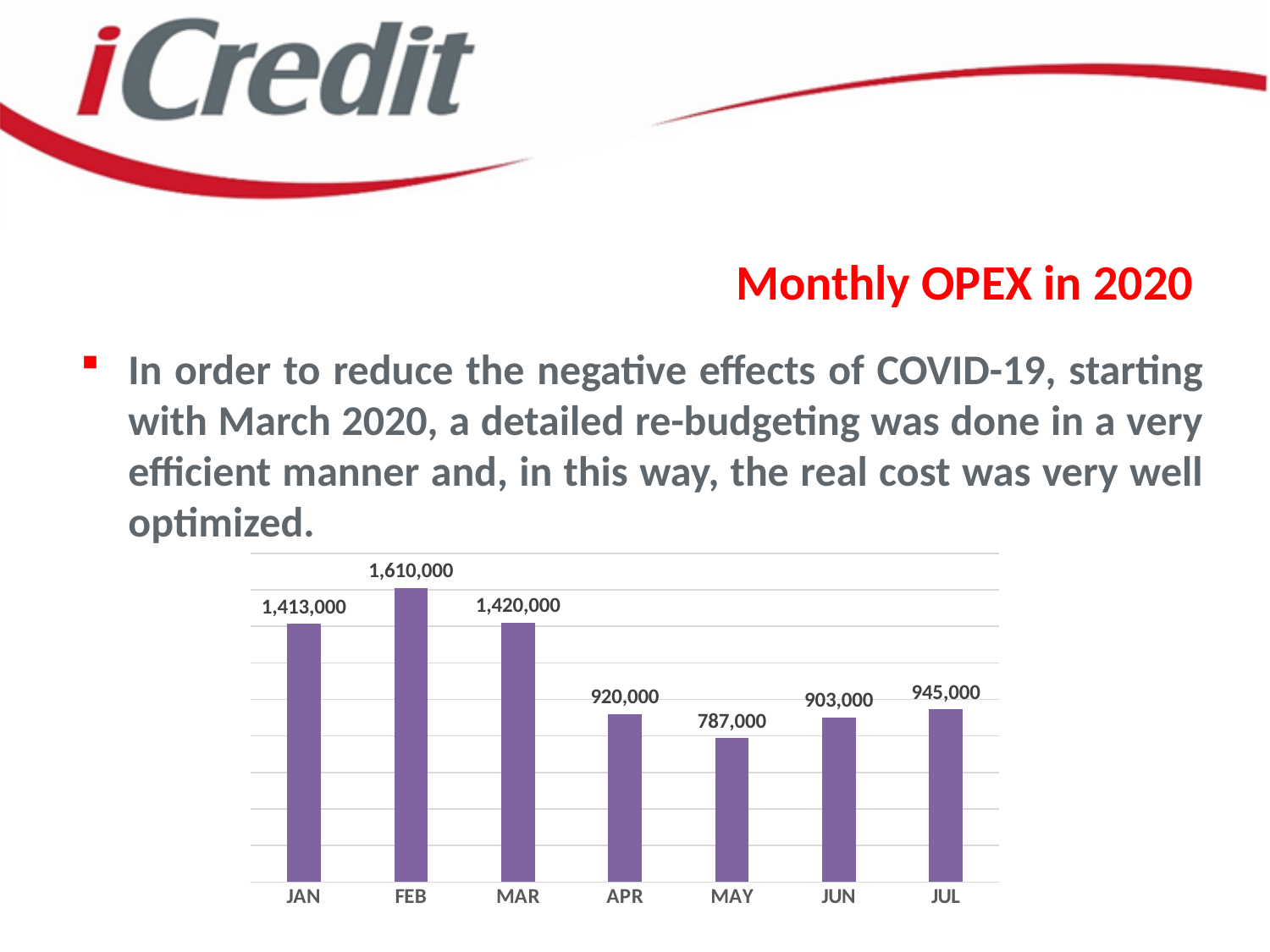
What kind of chart is shown on the slide? bar chart Which month has the lowest value? MAY What is the value for FEB? 1,610,000 What is the value for JUL? 945,000 How many months are shown on the x axis? 7 What is the difference between the values for APR and MAY? 133,000 Which month has the highest value? FEB Which is larger, the value for JAN or the value for MAR? MAR What is the difference between the values for FEB and MAR? 190,000 Which is larger, the value for JUN or the value for JUL? JUL What is the title of the chart? Monthly OPEX in 2020 What is the value for MAY? 787,000